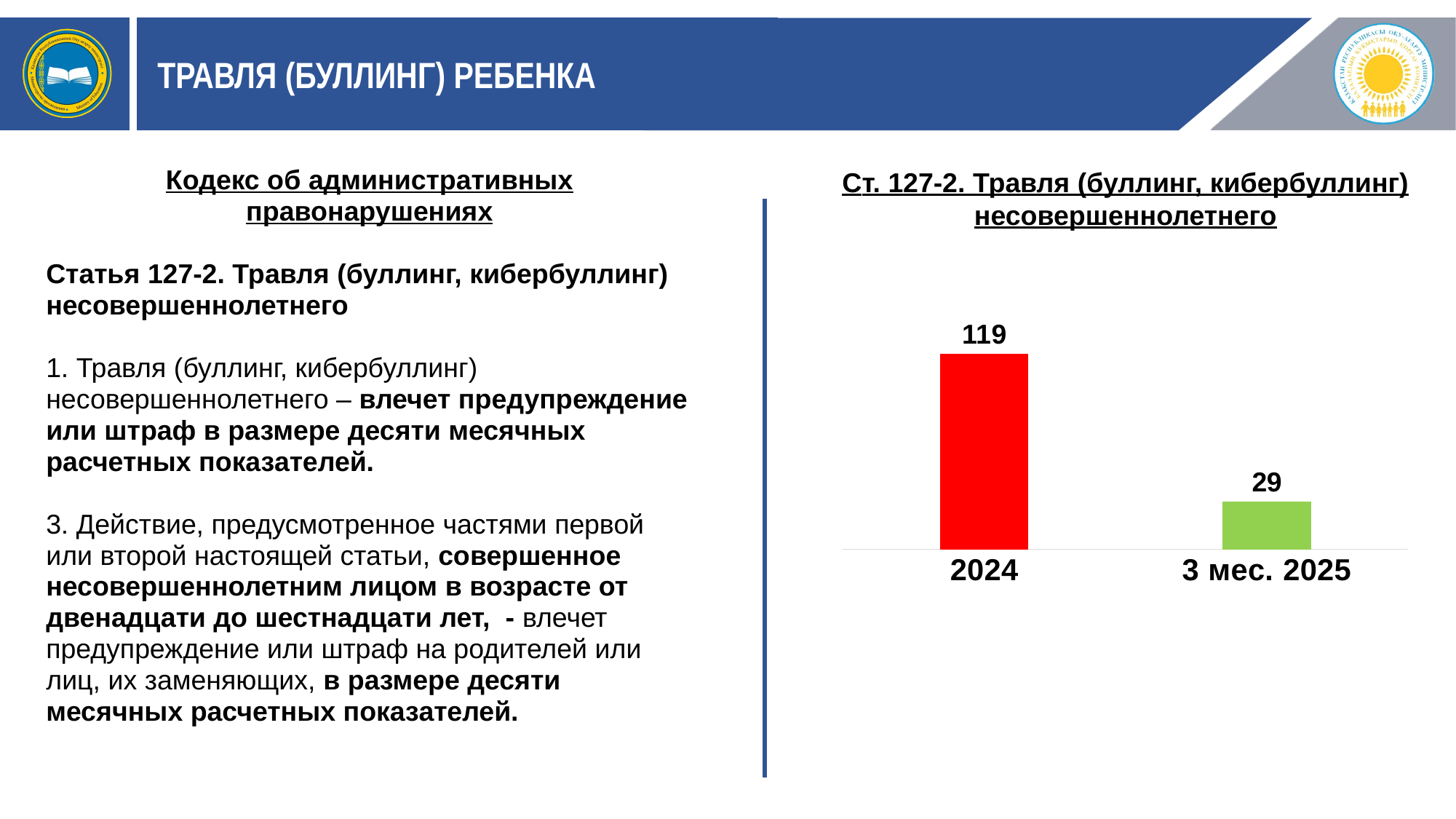
What is the value for 2024 in the chart? 119 What colour is the bar for 2024? Red Which category has the highest value in the chart? 2024 What kind of chart is shown on the slide? Bar chart Do the values rise or fall from 2024 to 3 мес. 2025? Fall What is the title of the chart? Ст. 127-2. Травля (буллинг, кибербуллинг) несовершеннолетнего What is the difference between the values for 2024 and 3 мес. 2025? 90 Which category has the lowest value in the chart? 3 мес. 2025 Which is larger, the value for 2024 or the value for 3 мес. 2025? 2024 What is the value for 3 мес. 2025 in the chart? 29 How many categories are shown in the chart? 2